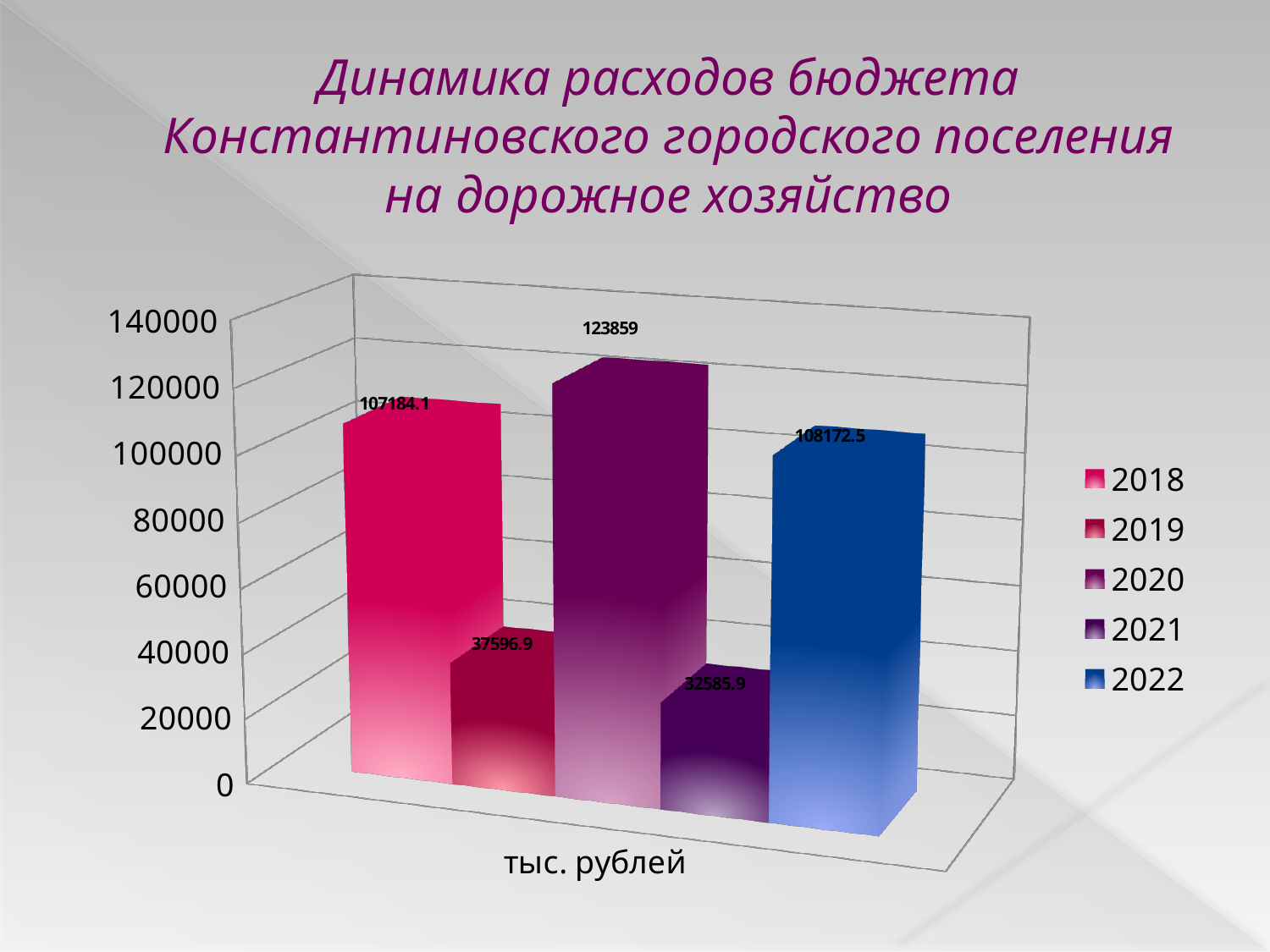
Which year has the highest value? 2020 What is the difference between the values for 2020 and 2018? 16674.9 What unit label is shown below the chart's horizontal axis? тыс. рублей What is the difference between the values for 2019 and 2021? 5011 How many series does the legend list? 5 Which is larger, the value for 2019 or the value for 2022? 2022 What is the value for 2022? 108172.5 What is the value for 2021? 32585.9 What kind of chart is shown on the slide? bar chart Which year has the lowest value? 2021 What is the value for 2018? 107184.1 What is the value for 2020? 123859